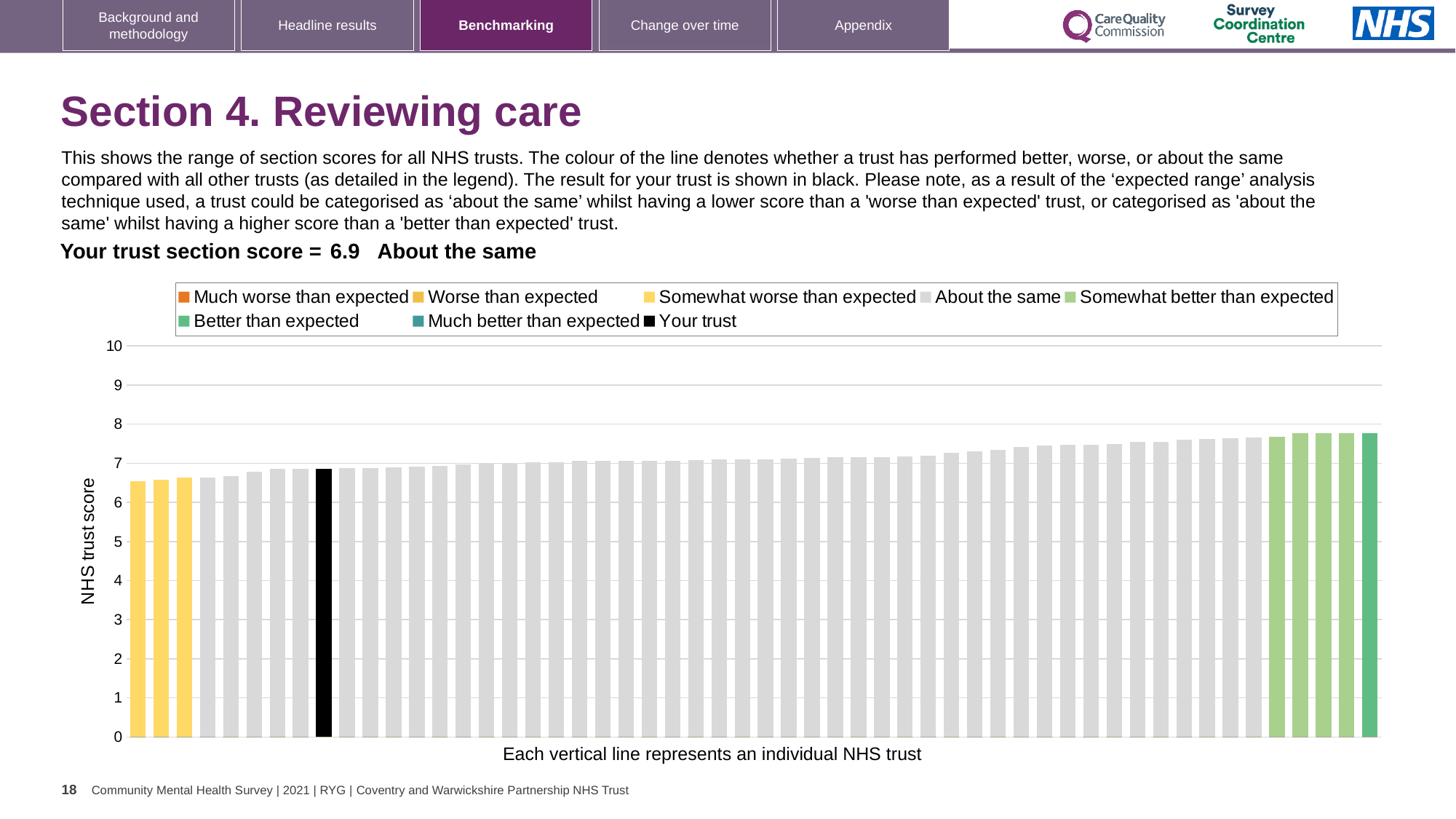
Which performance category is your trust placed in for this section? About the same Which legend category does the tallest bar on the far right belong to? Better than expected Is the value of the shortest bar in the chart greater or less than 7? less What is the label on the vertical axis of the chart? NHS trust score How many entries does the chart legend list? 8 Is the value of the tallest bar in the chart greater or less than 8? less Is the value of the black 'Your trust' bar greater or less than 5? greater How many bars are coloured as 'Somewhat worse than expected' (yellow)? 3 What kind of chart is shown on the slide? Bar chart How many bars are shown in black for 'Your trust'? 1 What is the section score for your trust shown on the slide? 6.9 Do the bar values rise or fall moving from left to right along the x axis? rise